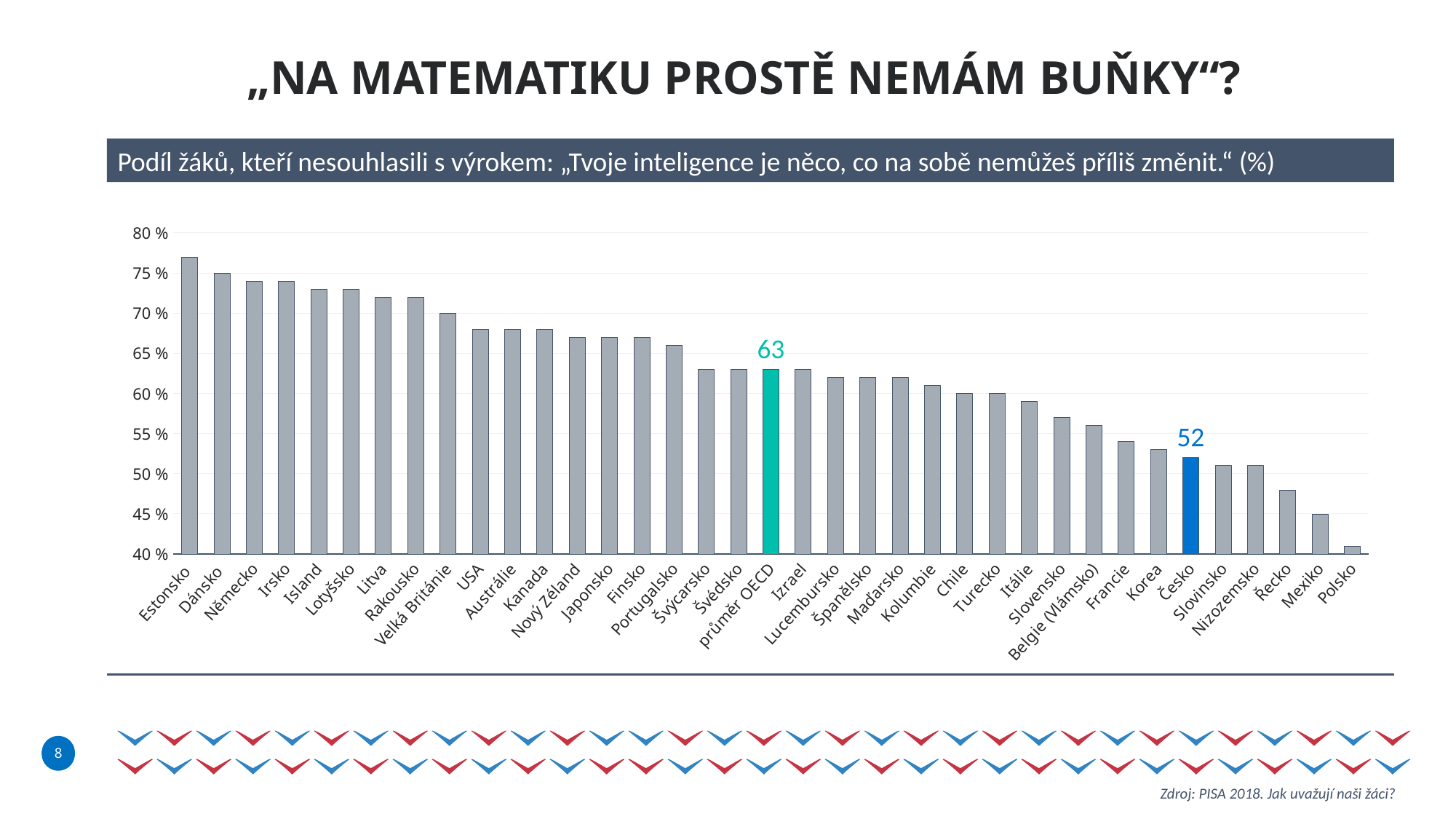
What kind of chart is shown on the slide? Bar chart What is the value shown for Česko? 52 What is the value shown for průměr OECD? 63 Do the values rise or fall from left to right along the x axis? Fall Which country has the lowest value in the chart? Polsko What colour is the bar for Česko? Blue Is the value for Velká Británie greater or less than 65 %? greater What is the difference between the value for průměr OECD and the value for Česko? 11 Is the value for Polsko greater or less than 45 %? less Which country has the highest value in the chart? Estonsko Which is larger, the value for Dánsko or the value for Mexiko? Dánsko How many countries/categories are shown on the x axis? 37